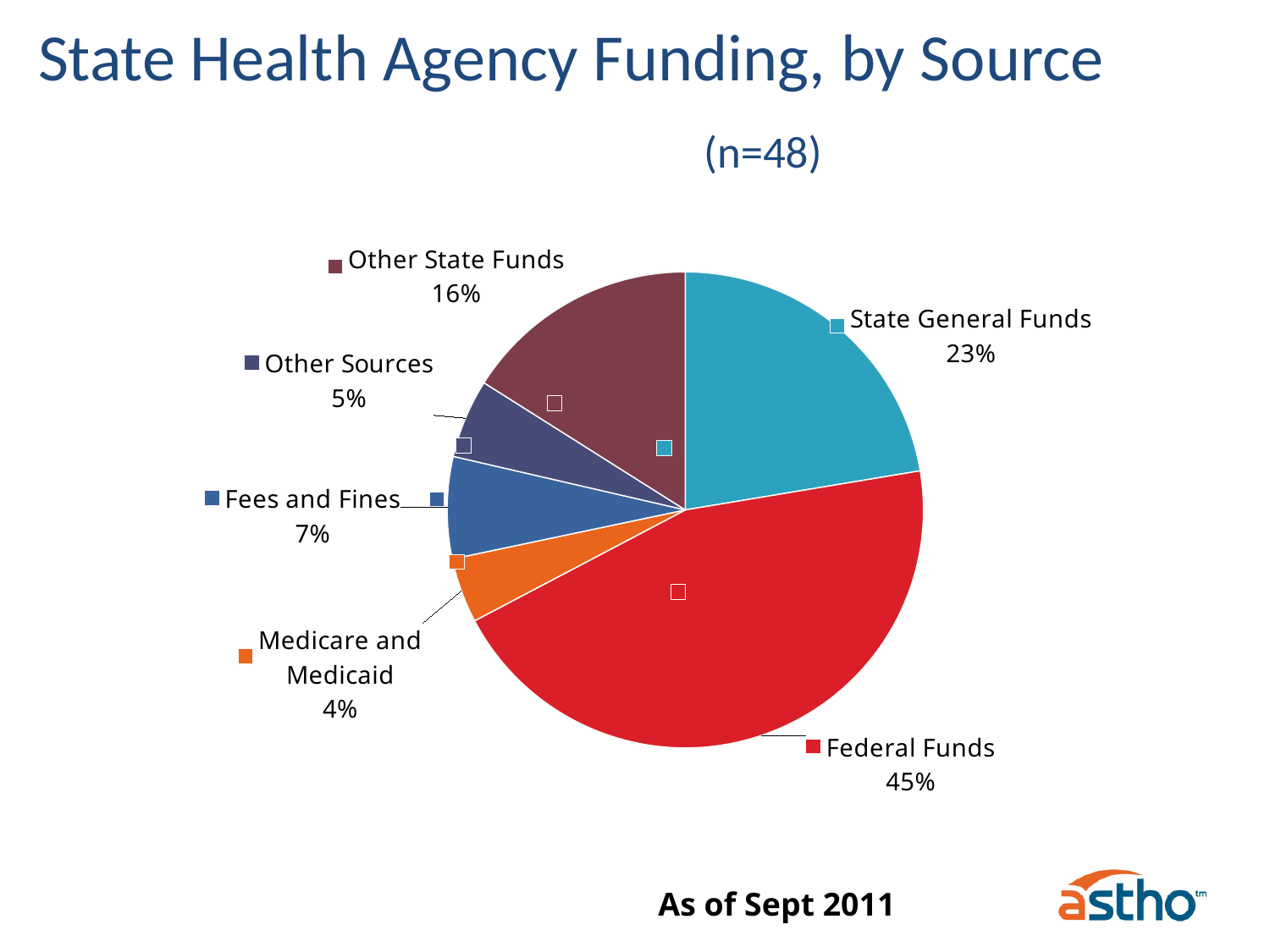
How many funding sources are shown in the pie chart? 6 What share of funding comes from State General Funds? 23% What is the difference in percentage points between Federal Funds and State General Funds? 22 percentage points What share of funding comes from Other State Funds? 16% Which funding source has the smallest share of the pie? Medicare and Medicaid What share of funding comes from Medicare and Medicaid? 4% What is the title of the chart? State Health Agency Funding, by Source What share of State Health Agency funding comes from Federal Funds? 45% Which is larger, the share for Fees and Fines or the share for Other Sources? Fees and Fines Which funding source has the largest share of the pie? Federal Funds What is the sample size (n) shown on the slide? 48 What kind of chart is shown on the slide? pie chart